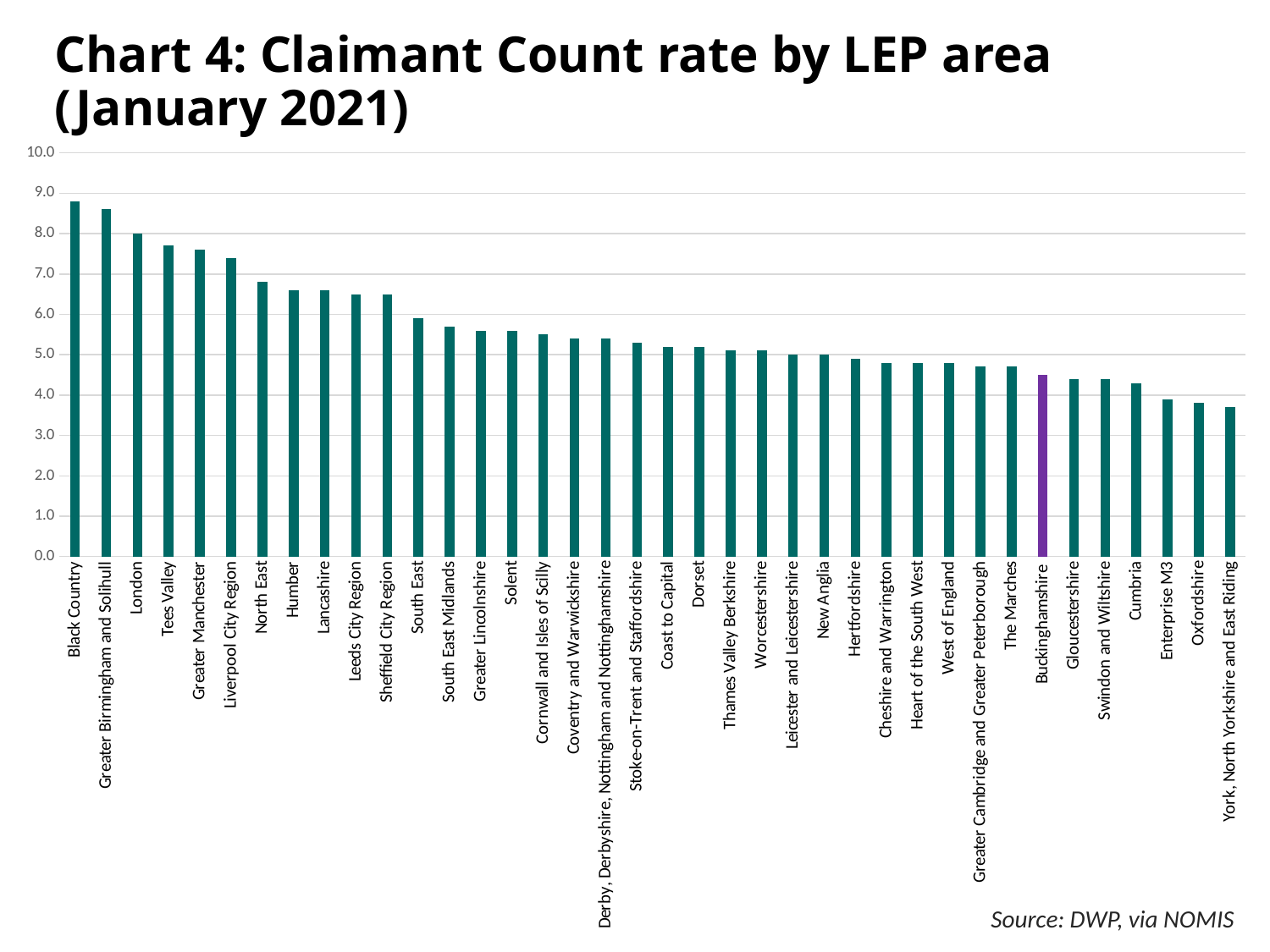
How many LEP areas are plotted on the chart? 38 Which LEP area has the highest Claimant Count rate? Black Country Which has a higher Claimant Count rate, Black Country or Buckinghamshire? Black Country Is the value for Buckinghamshire greater or less than 4.0? greater Do the values rise or fall moving from left to right along the x axis? Fall Which has a higher Claimant Count rate, London or Oxfordshire? London Is the value for Tees Valley greater or less than 7.0? greater What kind of chart is shown on the slide? Bar chart Is the value for Black Country greater or less than 8.0? greater Which LEP area's bar is shown in a different colour (purple) from the rest? Buckinghamshire